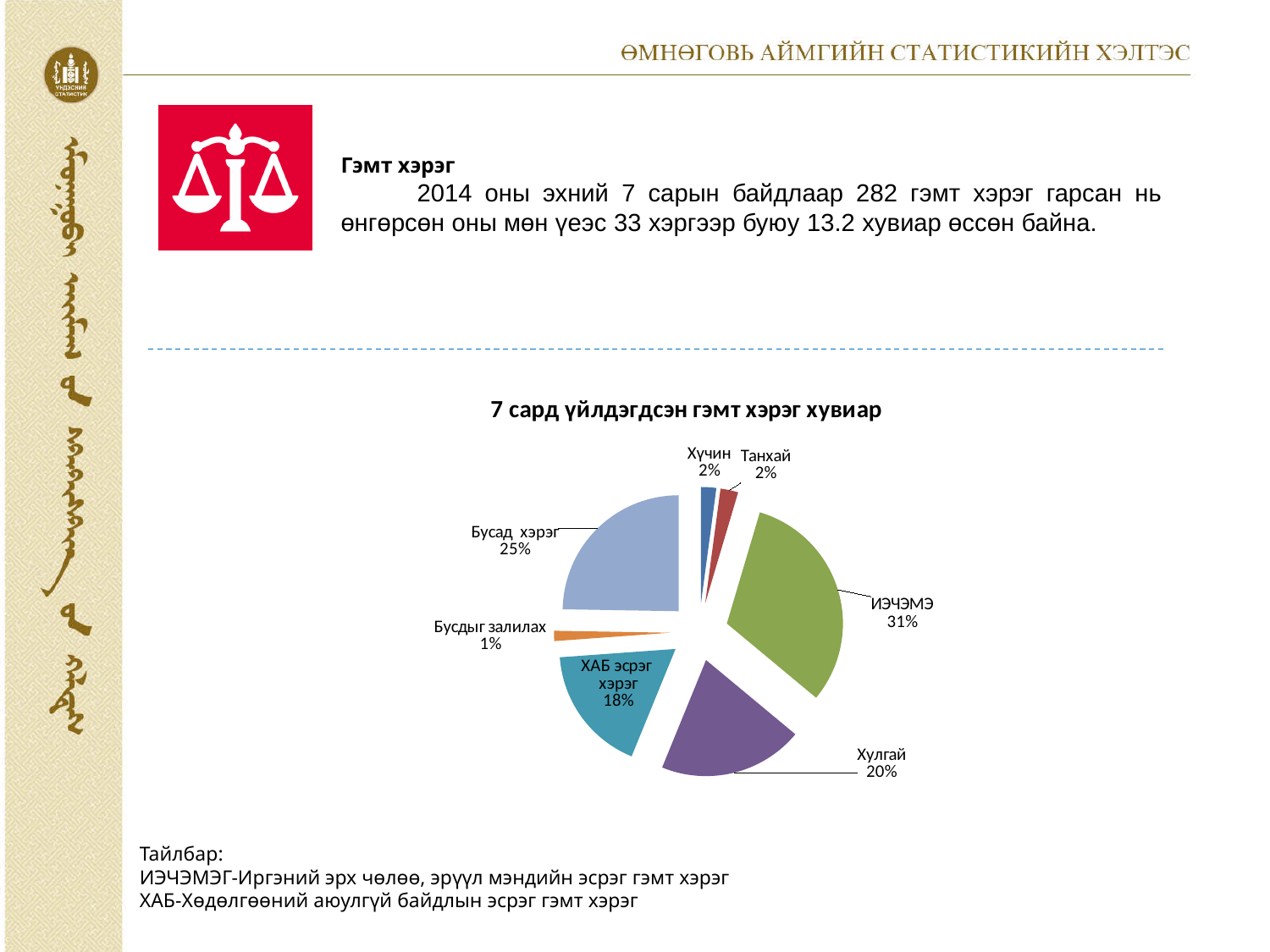
What type of chart is shown on the slide? pie chart Which category has the largest share of the pie? ИЭЧЭМЭ Which category has the smallest share of the pie? Бусдыг залилах How many slices does the pie chart have? 7 Which is larger, the share for Бусад хэрэг or the share for ХАБ эсрэг хэрэг? Бусад хэрэг What is the title of the chart? 7 сард үйлдэгдсэн гэмт хэрэг хувиар What is the value shown for Бусад хэрэг? 25% What is the value shown for Танхай? 2% What is the difference between the shares of ИЭЧЭМЭ and Хулгай? 11% What is the value shown for ХАБ эсрэг хэрэг? 18% What is the value shown for Хулгай? 20% What share of the pie does ИЭЧЭМЭ account for? 31%